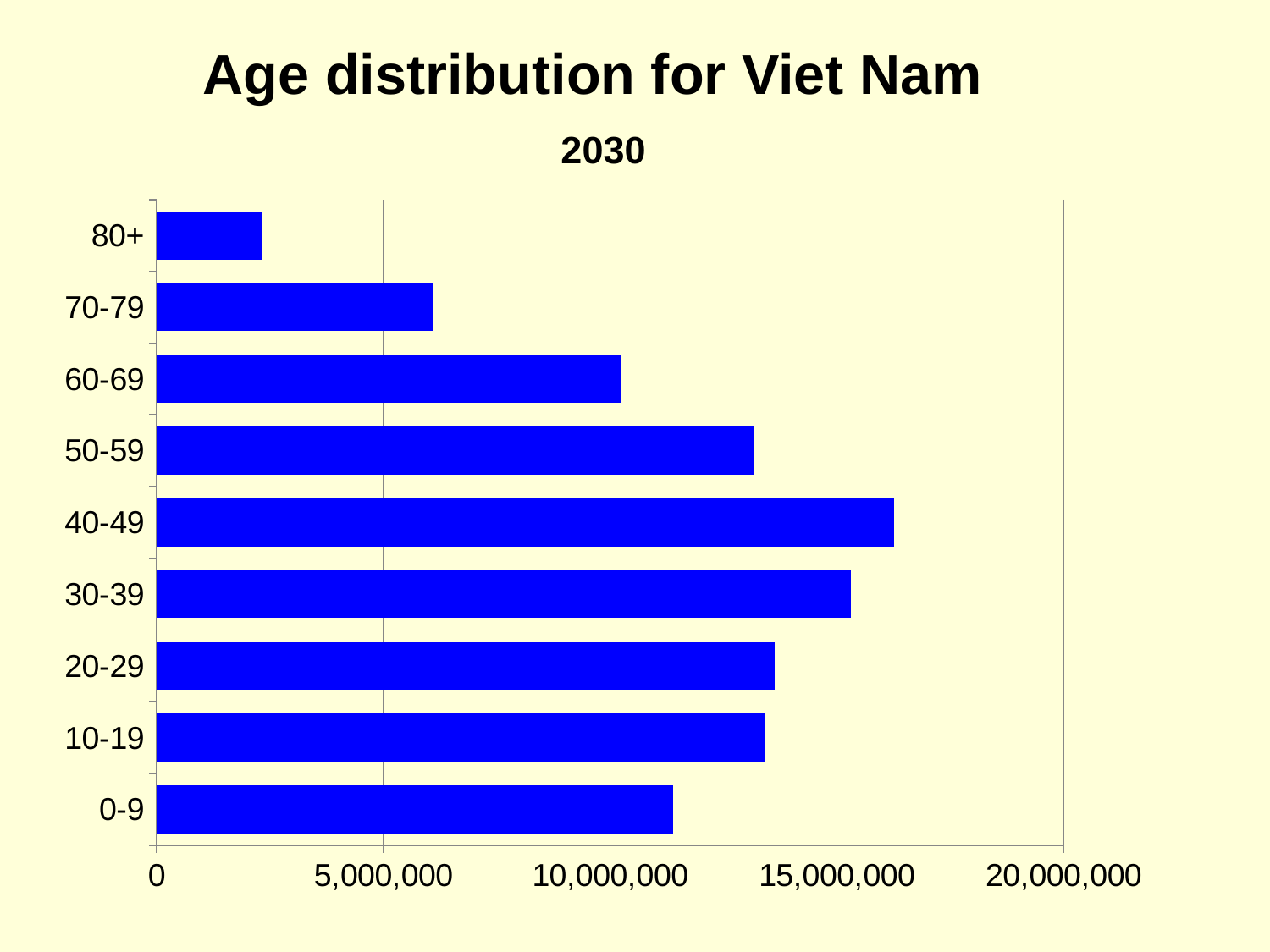
Which age group has a larger value, 40-49 or 30-39? 40-49 What is the title of the chart? Age distribution for Viet Nam What kind of chart is shown on the slide? bar chart Is the value for the 40-49 age group greater or less than 15,000,000? greater What year does the chart's subtitle refer to? 2030 Is the value for the 0-9 age group greater or less than 15,000,000? less Which age group has the largest population in the chart? 40-49 Which age group has a larger value, 70-79 or 80+? 70-79 How many age groups are shown in the chart? 9 Which age group has the smallest population in the chart? 80+ Is the value for the 80+ age group greater or less than 5,000,000? less